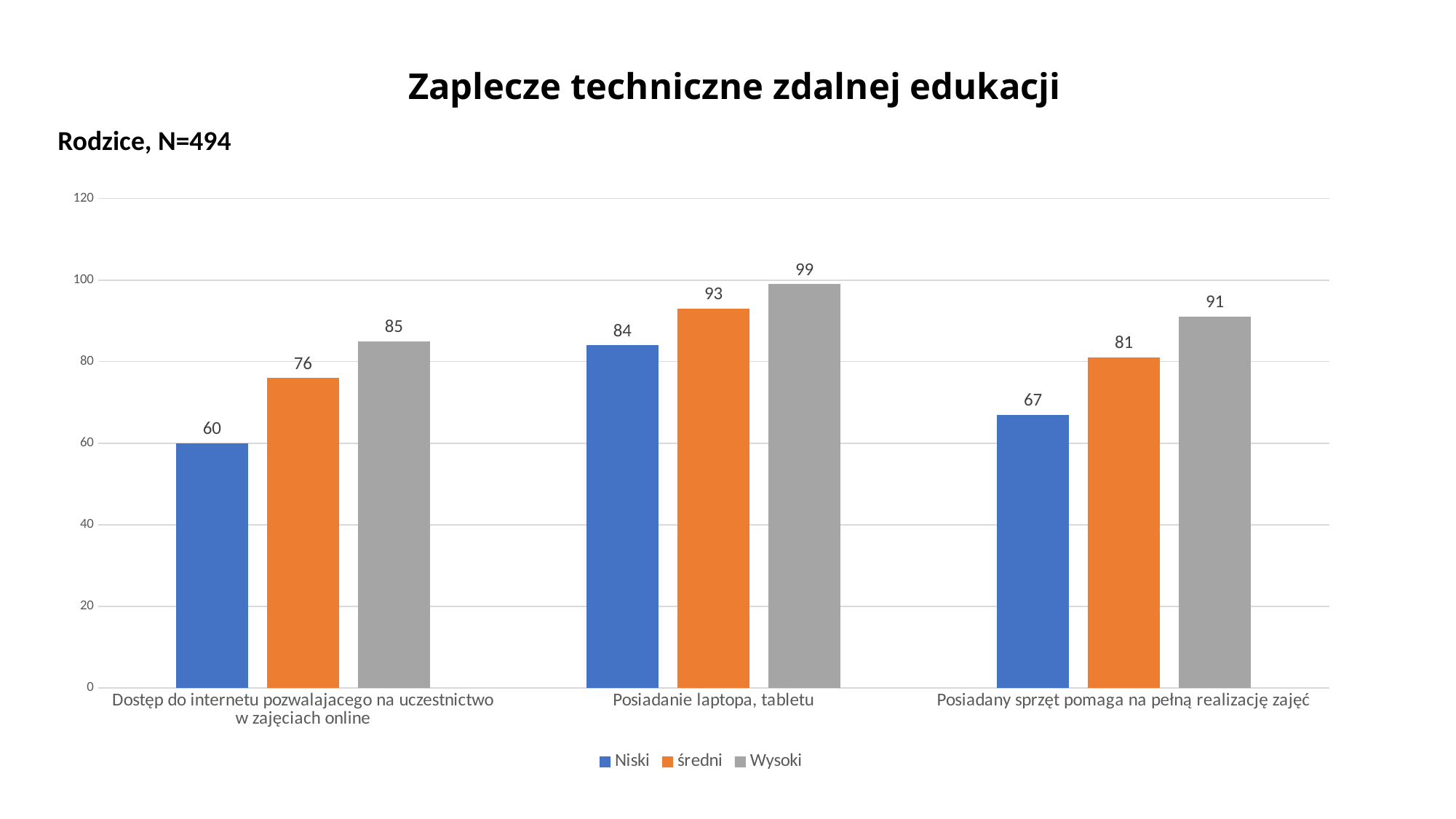
Which is larger: the średni value for "Posiadanie laptopa, tabletu" or the Wysoki value for "Dostęp do internetu pozwalajacego na uczestnictwo w zajęciach online"? średni value for Posiadanie laptopa, tabletu What is the title of the chart? Zaplecze techniczne zdalnej edukacji What is the value for Wysoki in the category "Posiadany sprzęt pomaga na pełną realizację zajęć"? 91 What kind of chart is shown on the slide? bar chart What is the difference between the Wysoki and Niski values for "Posiadany sprzęt pomaga na pełną realizację zajęć"? 24 Is the Niski value for "Posiadany sprzęt pomaga na pełną realizację zajęć" greater or less than 80? less What is the value for średni in the category "Dostęp do internetu pozwalajacego na uczestnictwo w zajęciach online"? 76 How many series does the legend list? 3 What is the value for Niski in the category "Posiadanie laptopa, tabletu"? 84 Which category has the lowest Niski value? Dostęp do internetu pozwalajacego na uczestnictwo w zajęciach online Which category has the highest Wysoki value? Posiadanie laptopa, tabletu How many categories are shown on the x axis? 3